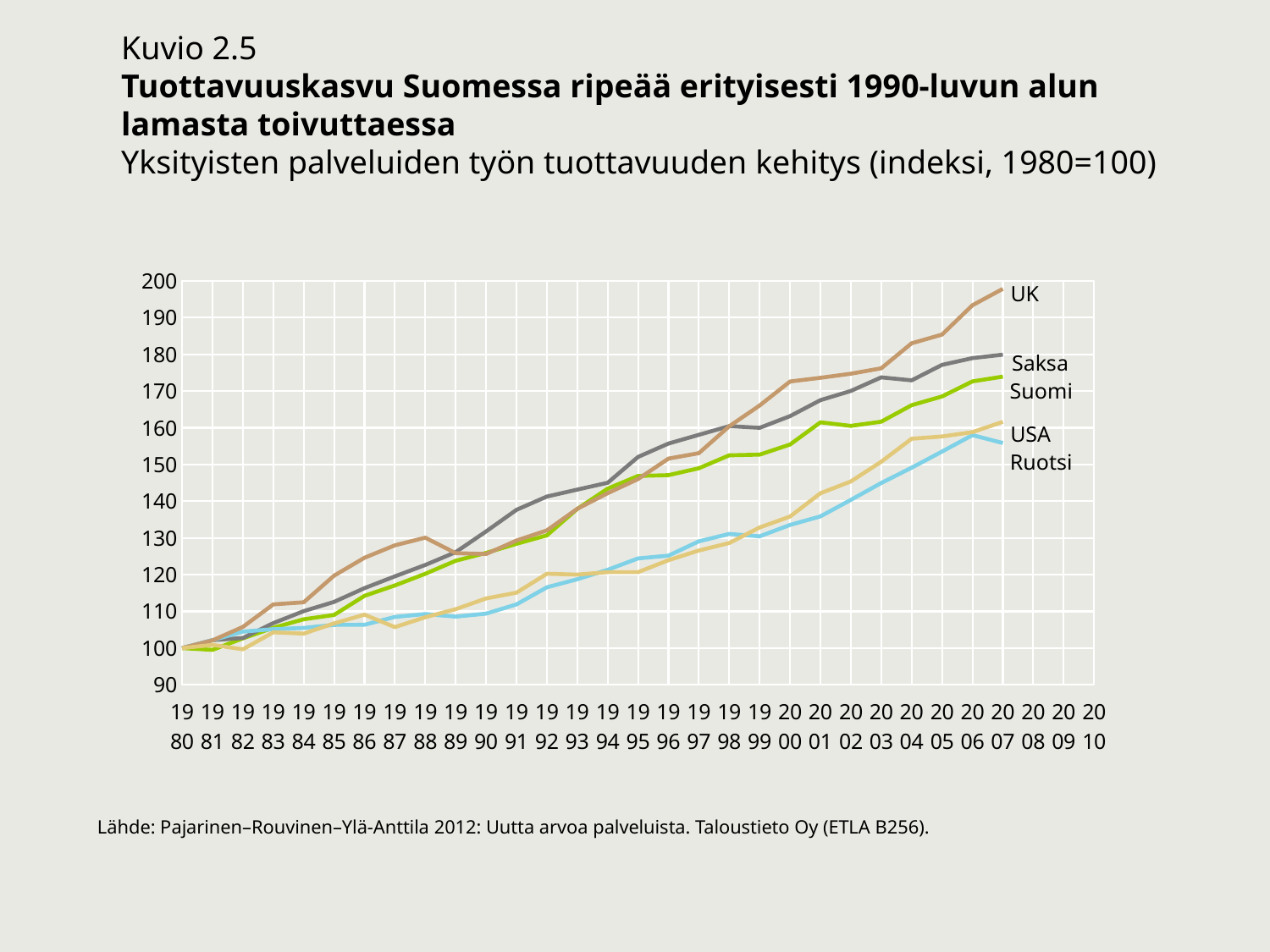
Does the UK line generally rise or fall from 1980 to 2007? rise How many years are labelled on the x axis? 31 Is the value for Suomi in 2007 greater or less than 170? greater What kind of chart is shown on the slide? line chart Which is larger in 2000, the value for Saksa or the value for USA? Saksa Which series has the highest value at the end of the plotted lines (2007)? UK Is the value for USA in 1995 greater or less than 130? less Is the value for UK in 2007 greater or less than 190? greater What is the index value of all series in 1980? 100 Which series has the lowest value at the end of the plotted lines (2007)? Ruotsi How many series (countries) are plotted in the chart? 5